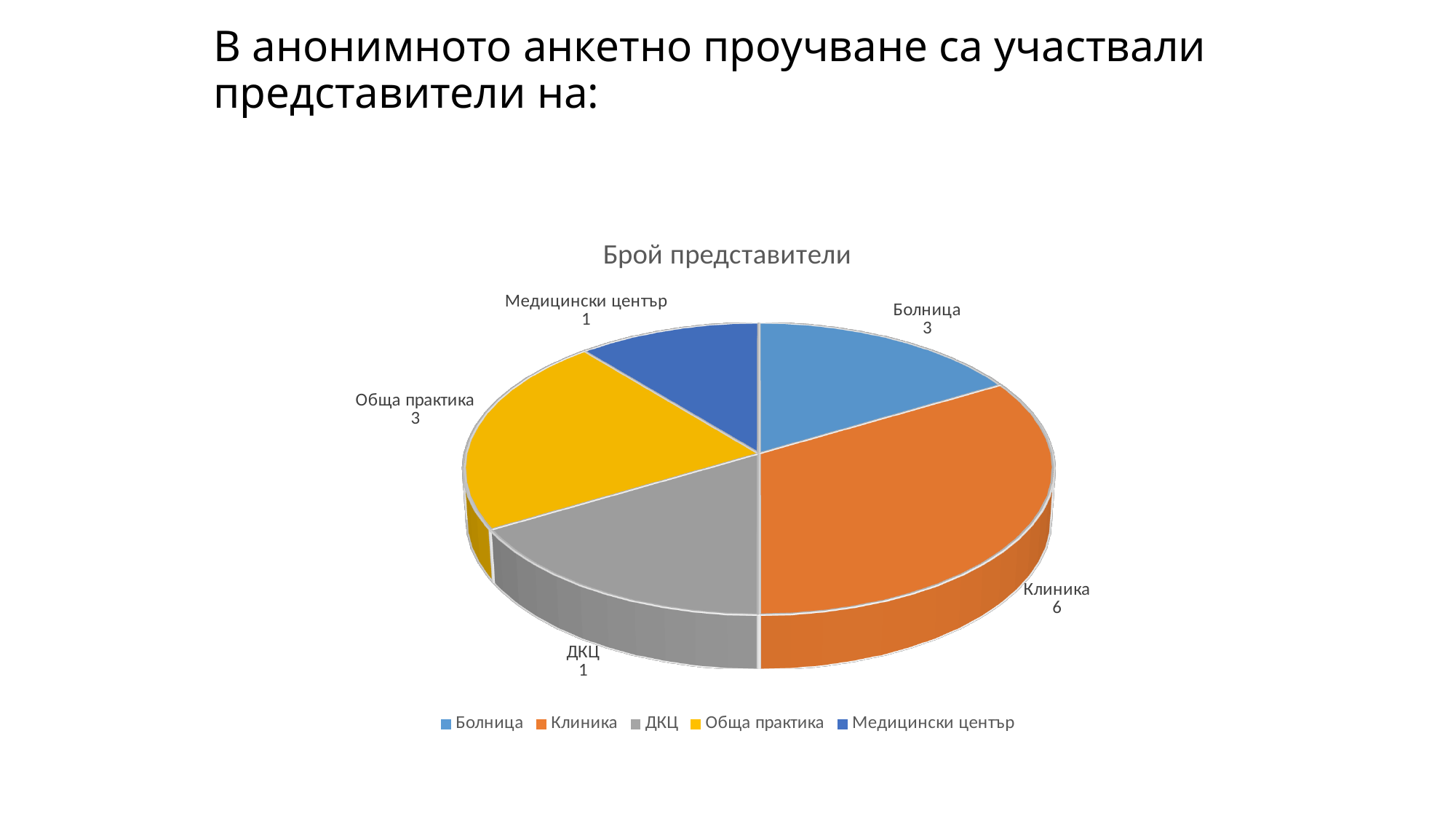
What kind of chart is shown on the slide? Pie chart What is the total of all values in the pie chart? 14 What is the value for Болница in the pie chart? 3 What is the difference between the values for Клиника and Болница? 3 What is the value for ДКЦ in the pie chart? 1 How many categories are shown in the pie chart? 5 Which is larger, the value for Обща практика or the value for ДКЦ? Обща практика What is the value for Клиника in the pie chart? 6 Which category has the largest slice in the pie chart? Клиника What is the value for Медицински център in the pie chart? 1 What is the title of the chart? Брой представители What is the value for Обща практика in the pie chart? 3